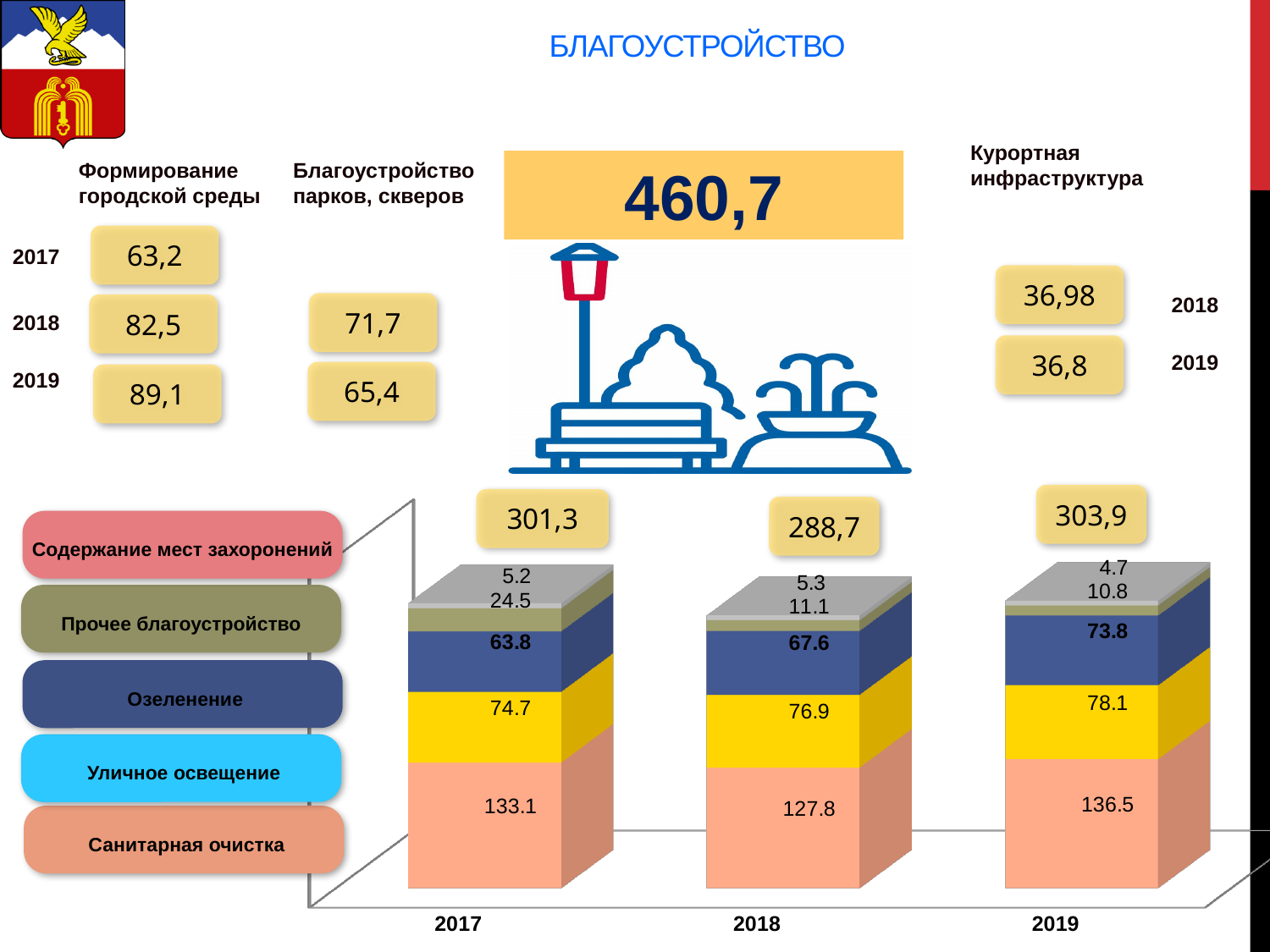
Is the value of Уличное освещение larger in 2019 or in 2017 in the stacked bar chart? 2019 Which year has the highest total in the stacked bar chart? 2019 What is the total shown above the 2018 bar in the stacked bar chart? 288,7 How many series does the legend of the stacked bar chart list? 5 What is the difference between the Озеленение values for 2019 and 2017 in the stacked bar chart? 10.0 Do the values of Уличное освещение rise or fall from 2017 to 2019 in the stacked bar chart? rise Which year has the lowest value for Санитарная очистка in the stacked bar chart? 2018 What is the value of Озеленение for 2018 in the stacked bar chart? 67.6 What is the value of Прочее благоустройство for 2017 in the stacked bar chart? 24.5 What is the value of Санитарная очистка for 2019 in the stacked bar chart? 136.5 How many years (categories) are shown on the x axis of the stacked bar chart? 3 What kind of chart is shown at the bottom of the slide? stacked bar chart